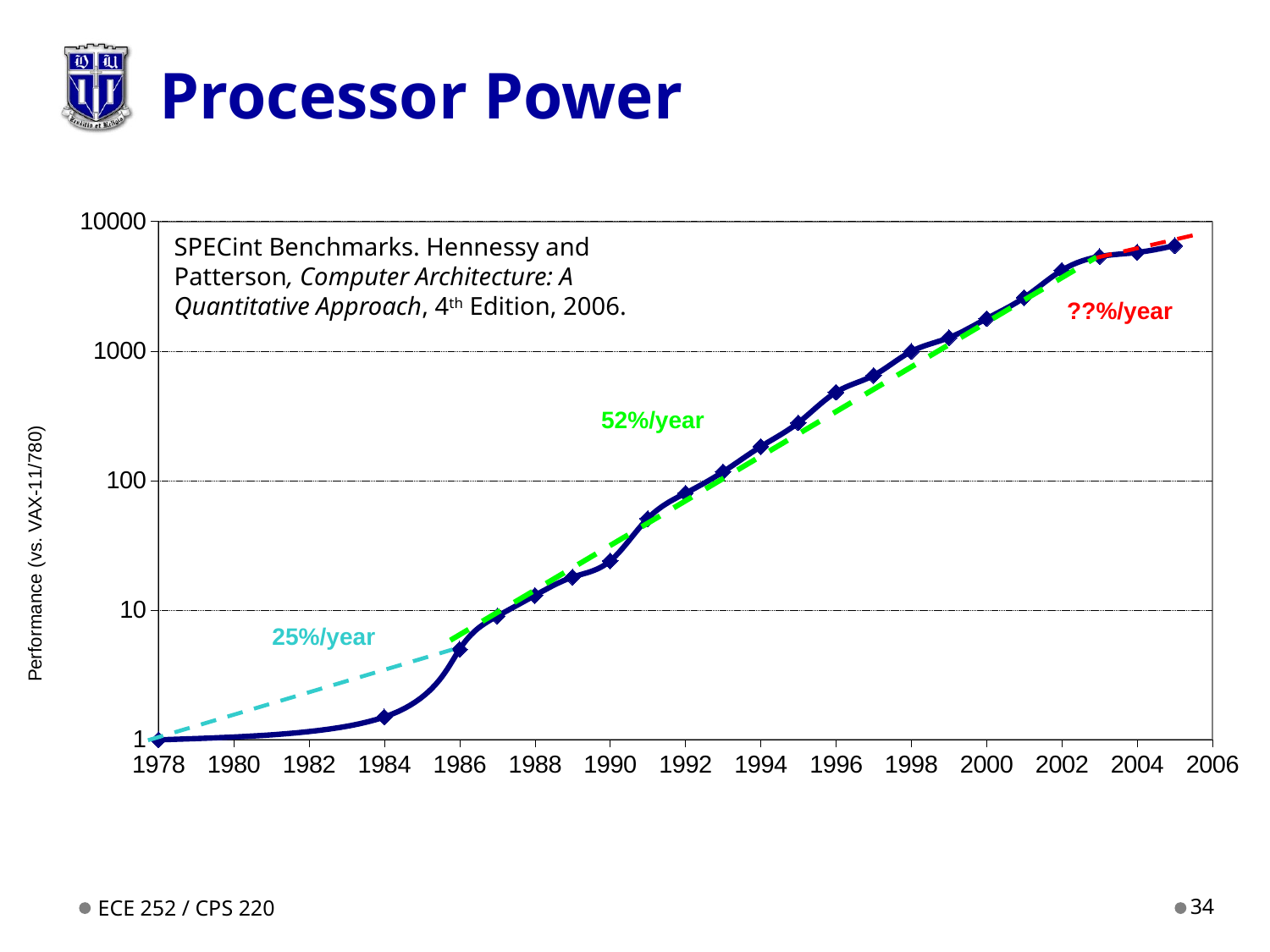
Which year has the lowest plotted performance value? 1978 What kind of chart is shown on the slide? line chart Which year has the larger plotted value, 1992 or 2000? 2000 Is the value for 1984 greater or less than 10? less Which year has the highest plotted performance value? 2005 Is the value for 1996 greater or less than 100? greater What growth rate is annotated on the green dashed trend line? 52%/year Do the plotted performance values rise or fall from 1978 to 2005? rise Is the value for 2005 greater or less than 10000? less What is the label on the y axis of the chart? Performance (vs. VAX-11/780)